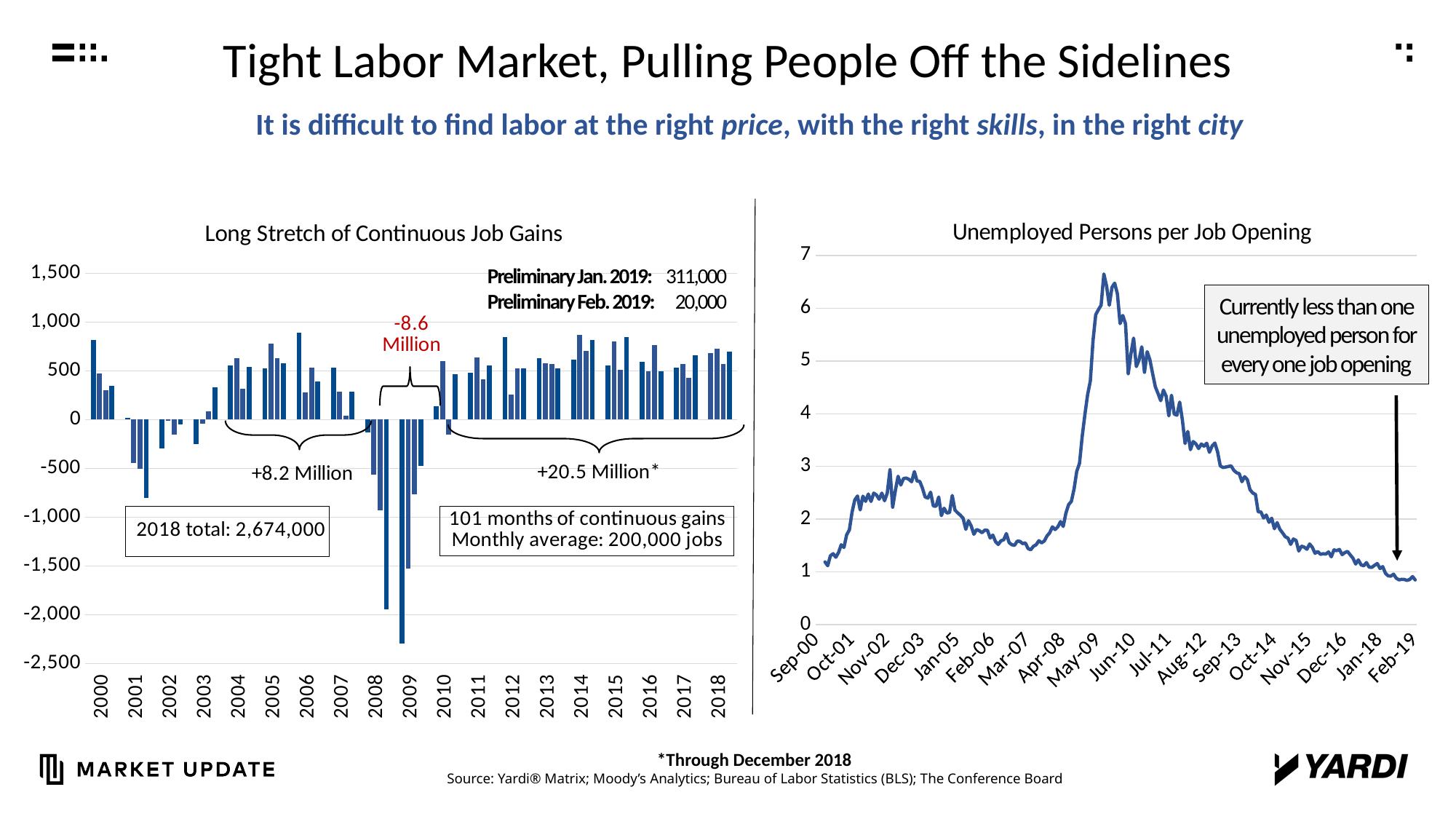
In the 'Unemployed Persons per Job Opening' chart, is the value at Feb-19 greater or less than 1? less What kind of chart is the 'Long Stretch of Continuous Job Gains' chart on the left? Bar chart In the 'Long Stretch of Continuous Job Gains' chart, what is the preliminary job gain figure for Jan. 2019? 311,000 In the 'Long Stretch of Continuous Job Gains' chart, which year contains the lowest (most negative) monthly bar? 2009 In the 'Long Stretch of Continuous Job Gains' chart, what cumulative gain is labeled for the period from 2010 onward? +20.5 Million In the 'Long Stretch of Continuous Job Gains' chart, what cumulative change is labeled for the 2008–2009 period of job losses? -8.6 Million In the 'Long Stretch of Continuous Job Gains' chart, what is the preliminary job gain figure for Feb. 2019? 20,000 In the 'Unemployed Persons per Job Opening' chart, is the peak value greater or less than 6? greater What kind of chart is the 'Unemployed Persons per Job Opening' chart on the right? Line chart In the 'Long Stretch of Continuous Job Gains' chart, how many months of continuous gains are noted? 101 months In the 'Long Stretch of Continuous Job Gains' chart, what is the 2018 total of job gains shown? 2,674,000 In the 'Long Stretch of Continuous Job Gains' chart, what cumulative gain is labeled for the 2004–2007 period? +8.2 Million